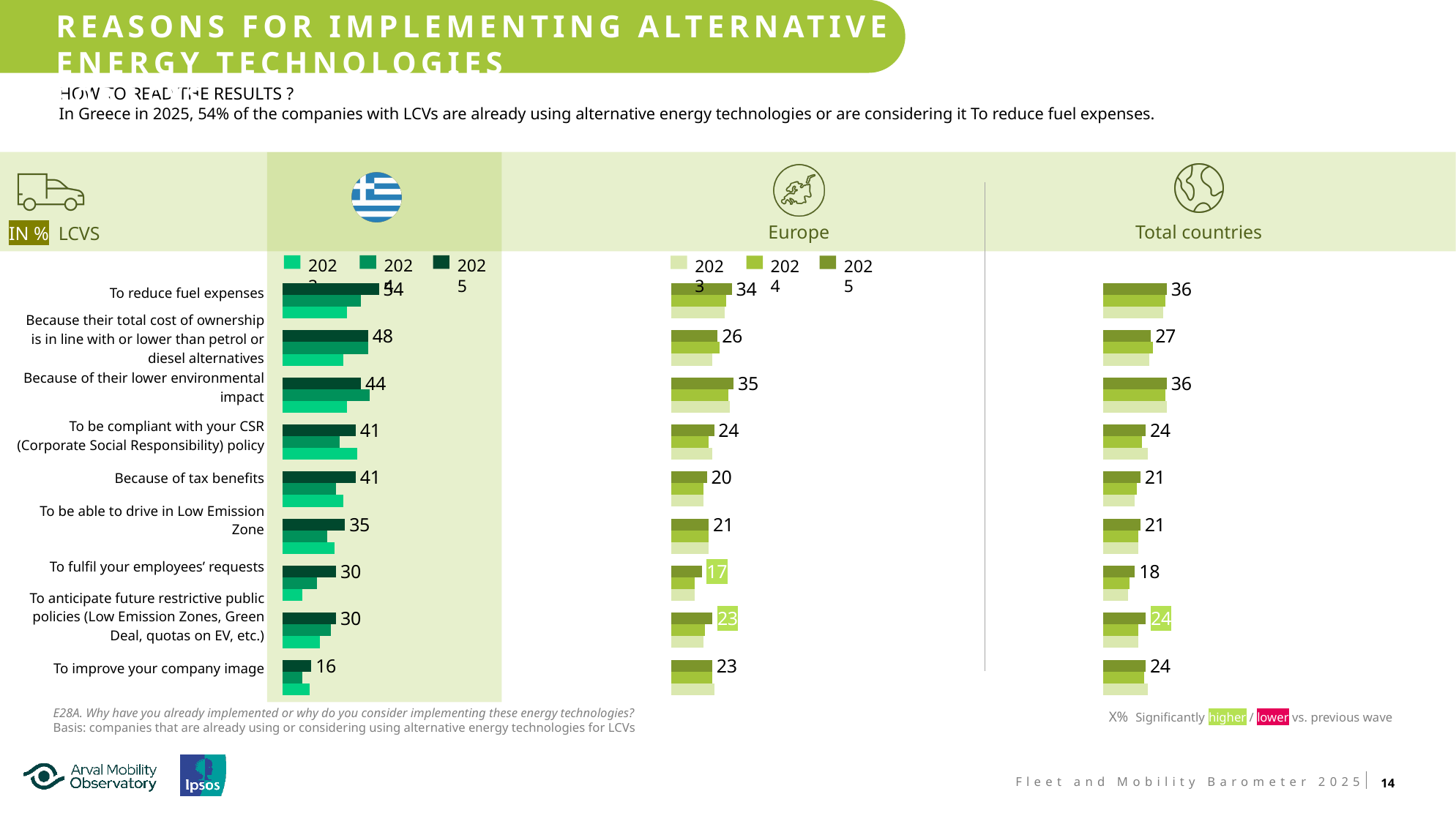
For "Because of tax benefits" in 2025, which is larger: the Greece value or the Europe value? Greece In the Total countries chart, what is the difference between the 2025 values for "To reduce fuel expenses" and "Because their total cost of ownership is in line with or lower than petrol or diesel alternatives"? 9 In the Europe chart, what is the 2025 value for "Because of their lower environmental impact"? 35 How many reasons (categories) are listed in the charts? 9 In the Greece chart, what is the difference between the 2025 values for "To reduce fuel expenses" and "To improve your company image"? 38 How many series does the legend of the Greece chart list? 3 What kind of chart is used to show the results for Greece? Bar chart In the Europe chart, what is the 2025 value for "To fulfil your employees' requests"? 17 In the Greece chart, which reason has the lowest 2025 value? To improve your company image In the Europe chart, which reason has the highest 2025 value? Because of their lower environmental impact In the Greece chart, what is the 2025 value for "To reduce fuel expenses"? 54 In the Total countries chart, what is the 2025 value for "To fulfil your employees' requests"? 18